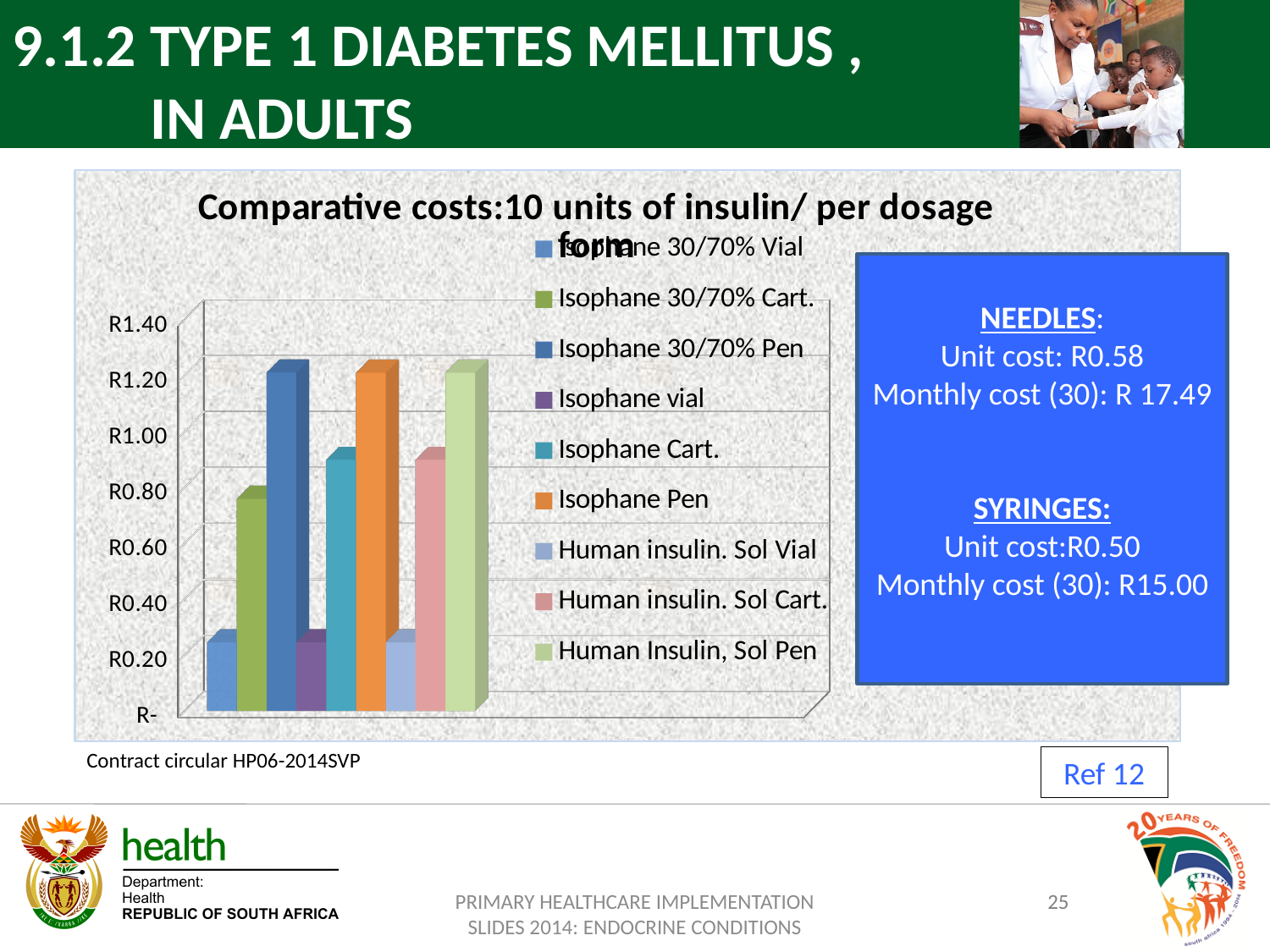
How many series does the chart legend list? 9 How many bars are plotted in the chart? 9 Is the value for Isophane 30/70% Cart. greater or less than R0.60? greater What is the title of the chart? Comparative costs:10 units of insulin/ per dosage form Is the value for Isophane 30/70% Pen greater or less than R1.00? greater Is the value for Isophane Cart. greater or less than R1.00? less Which is larger, the value for Isophane 30/70% Pen or the value for Isophane 30/70% Vial? Isophane 30/70% Pen Which is larger, the value for Isophane Cart. or the value for Isophane 30/70% Cart.? Isophane Cart. What kind of chart is shown on the slide? bar chart